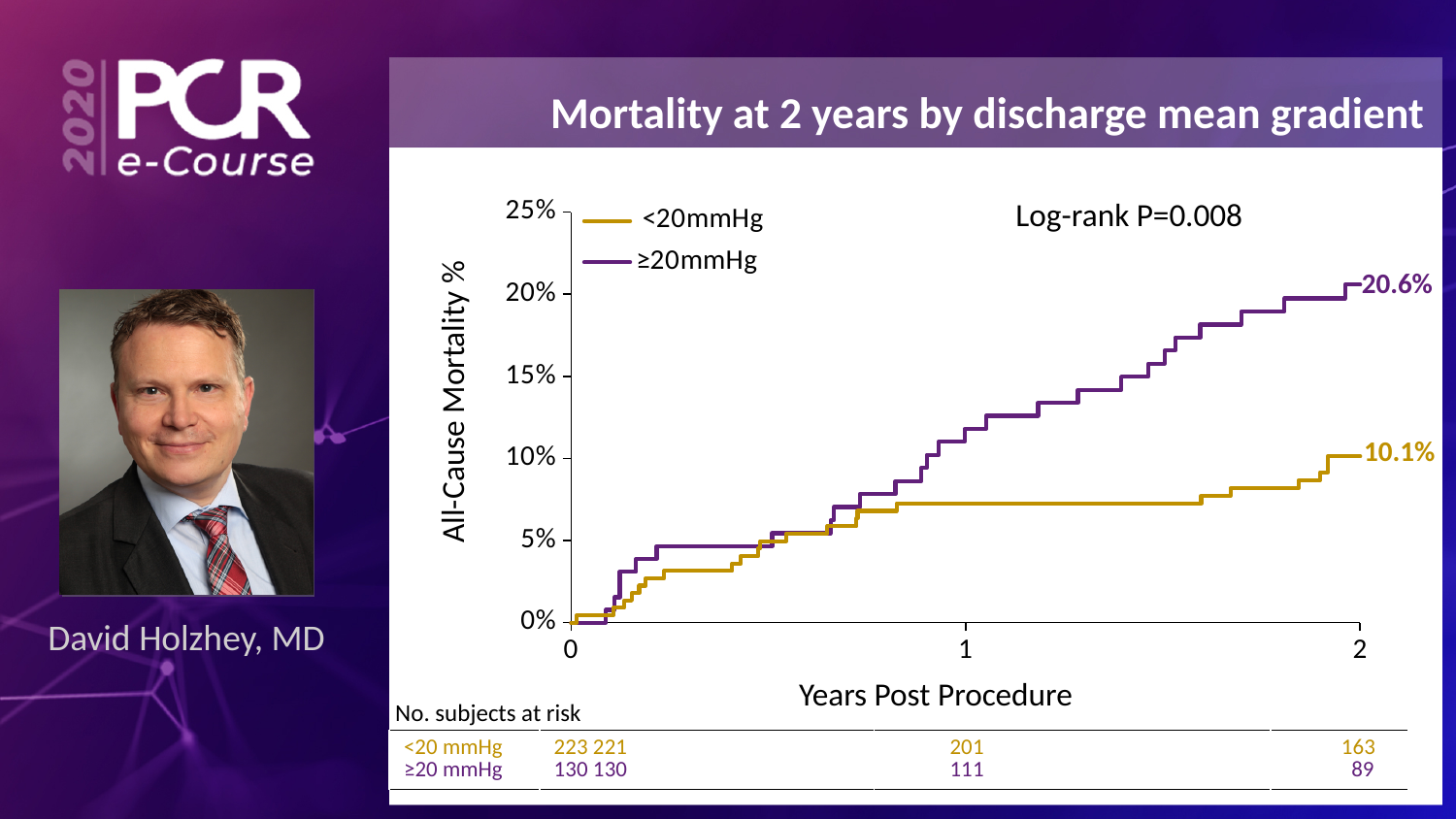
Which group has the lower all-cause mortality at 2 years? <20mmHg How many subjects in the ≥20 mmHg group were at risk at 2 years? 89 How many series does the legend list? 2 Do the mortality curves rise or fall as years post procedure increase? Rise What is the all-cause mortality at 2 years for the ≥20mmHg group? 20.6% What is the difference in 2-year all-cause mortality between the ≥20mmHg and <20mmHg groups? 10.5% What is the log-rank P value shown on the chart? P=0.008 Is the 2-year mortality for the ≥20mmHg group greater or less than 20%? greater Which group has the higher all-cause mortality at 2 years? ≥20mmHg What kind of chart is shown on the slide? Line chart (Kaplan-Meier curve) What is the all-cause mortality at 2 years for the <20mmHg group? 10.1% Is the mortality for the <20mmHg group at 1 year greater or less than 10%? less